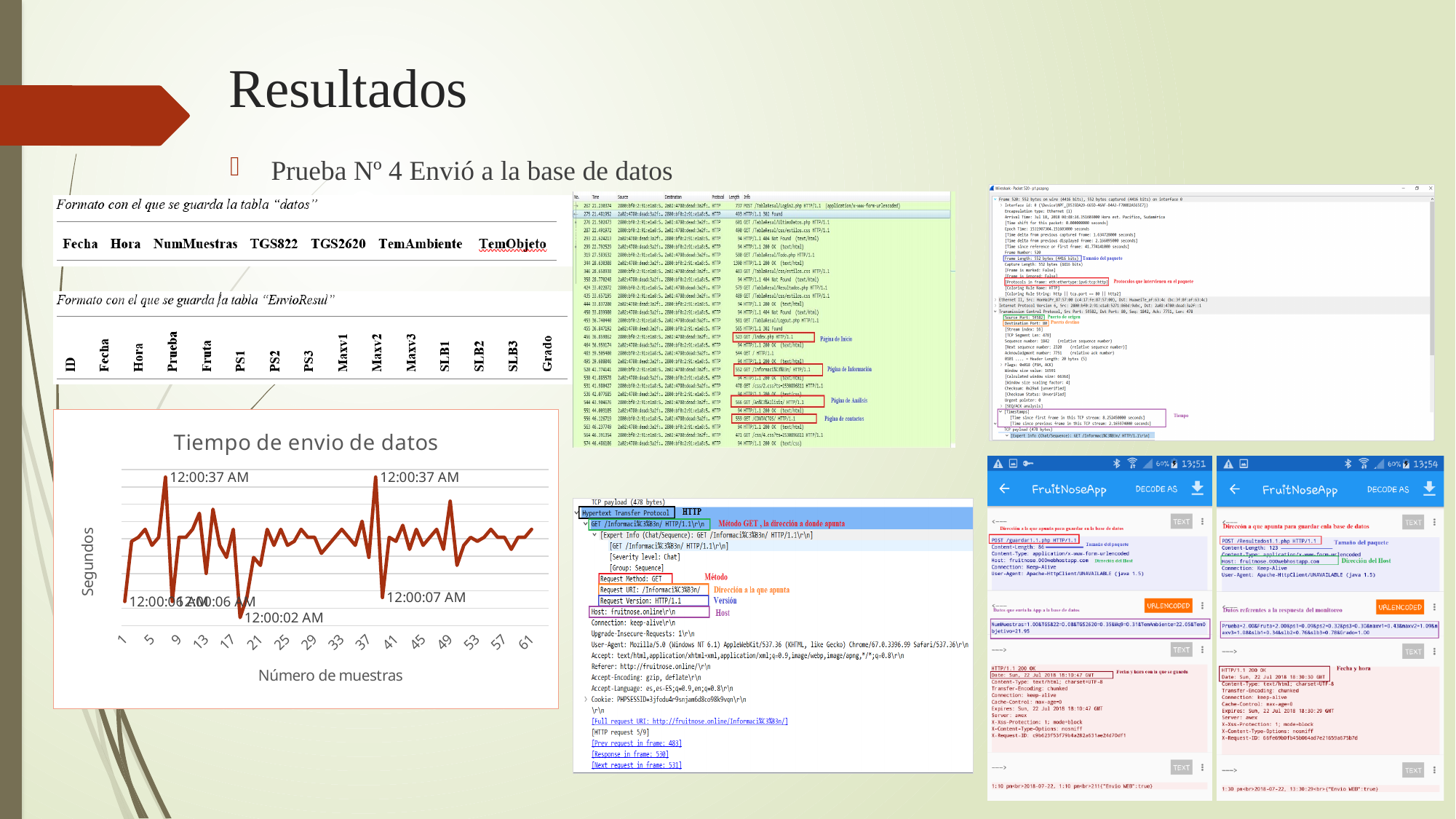
In the chart "Tiempo de envio de datos", which labeled value is larger: 12:00:37 AM or 12:00:07 AM? 12:00:37 AM In the chart "Tiempo de envio de datos", how many data labels read "12:00:37 AM"? 2 How many tick labels are shown on the x-axis of the chart "Tiempo de envio de datos"? 16 What is the last tick label on the x-axis of the chart "Tiempo de envio de datos"? 61 How many lines are plotted in the chart "Tiempo de envio de datos"? 1 In the chart "Tiempo de envio de datos", what is the highest value shown as a data label? 12:00:37 AM In the chart "Tiempo de envio de datos", what is the lowest value shown as a data label? 12:00:02 AM What is the title of the chart on the slide? Tiempo de envio de datos What is the x-axis title of the chart "Tiempo de envio de datos"? Número de muestras What is the first tick label on the x-axis of the chart "Tiempo de envio de datos"? 1 In the chart "Tiempo de envio de datos", does the line rise steadily, fall steadily, or fluctuate along the x-axis? fluctuate What kind of chart is "Tiempo de envio de datos"? line chart